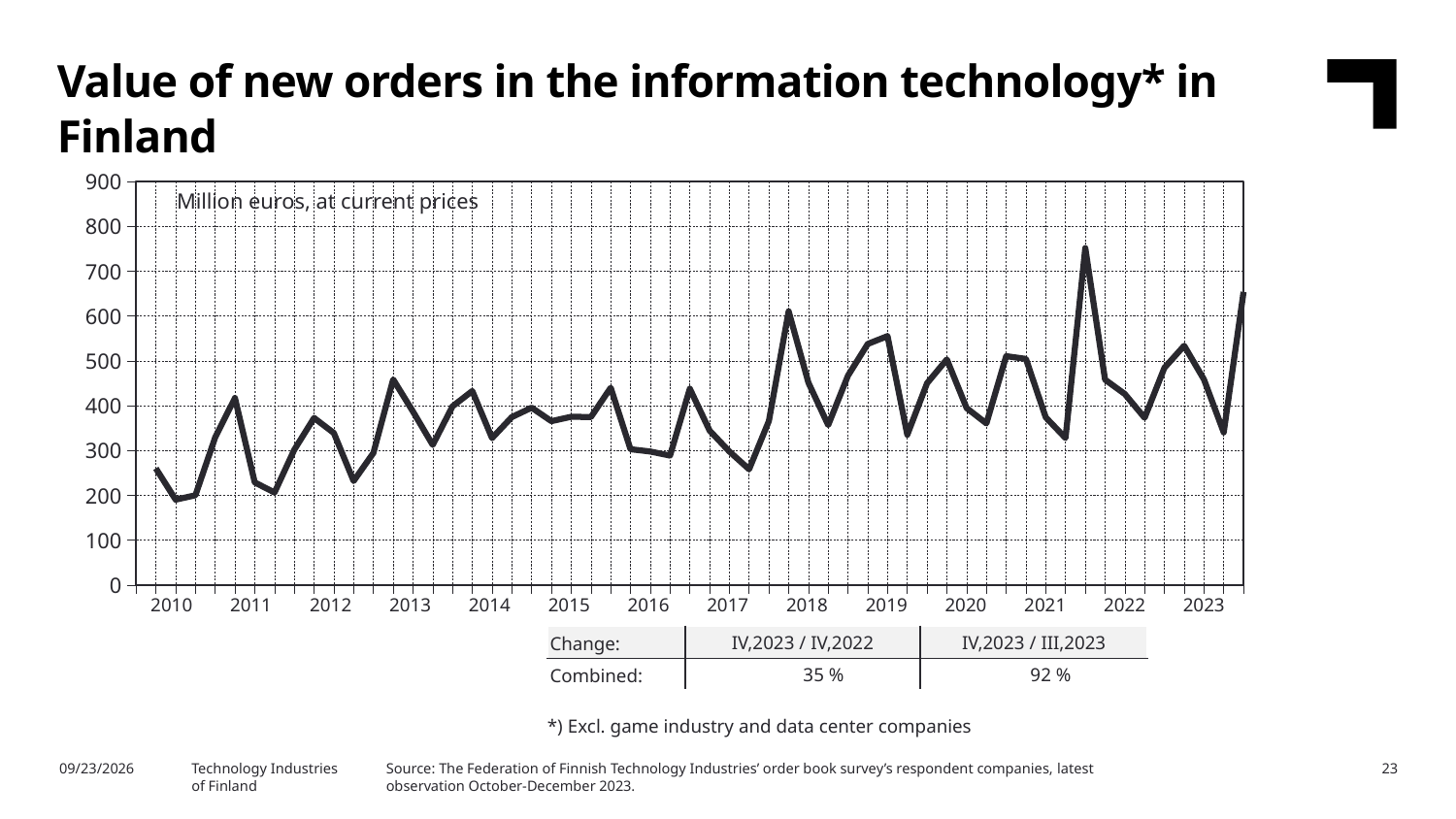
In which year does the line reach its highest point? 2021 How many years are labeled on the x axis of the chart? 14 What is the title of the chart on the slide? Value of new orders in the information technology* in Finland In what unit are the values on the chart expressed, according to the label inside the plot area? Million euros, at current prices Is the highest point on the line greater or less than 700? greater What type of chart is shown on the slide? line chart What is the combined change for IV,2023 / III,2023 shown below the chart? 92 % Is the peak value in 2018 greater or less than 500? greater Is the lowest value plotted in 2010 greater or less than 250? less What is the maximum value shown on the y axis of the chart? 900 What is the combined change for IV,2023 / IV,2022 shown below the chart? 35 %